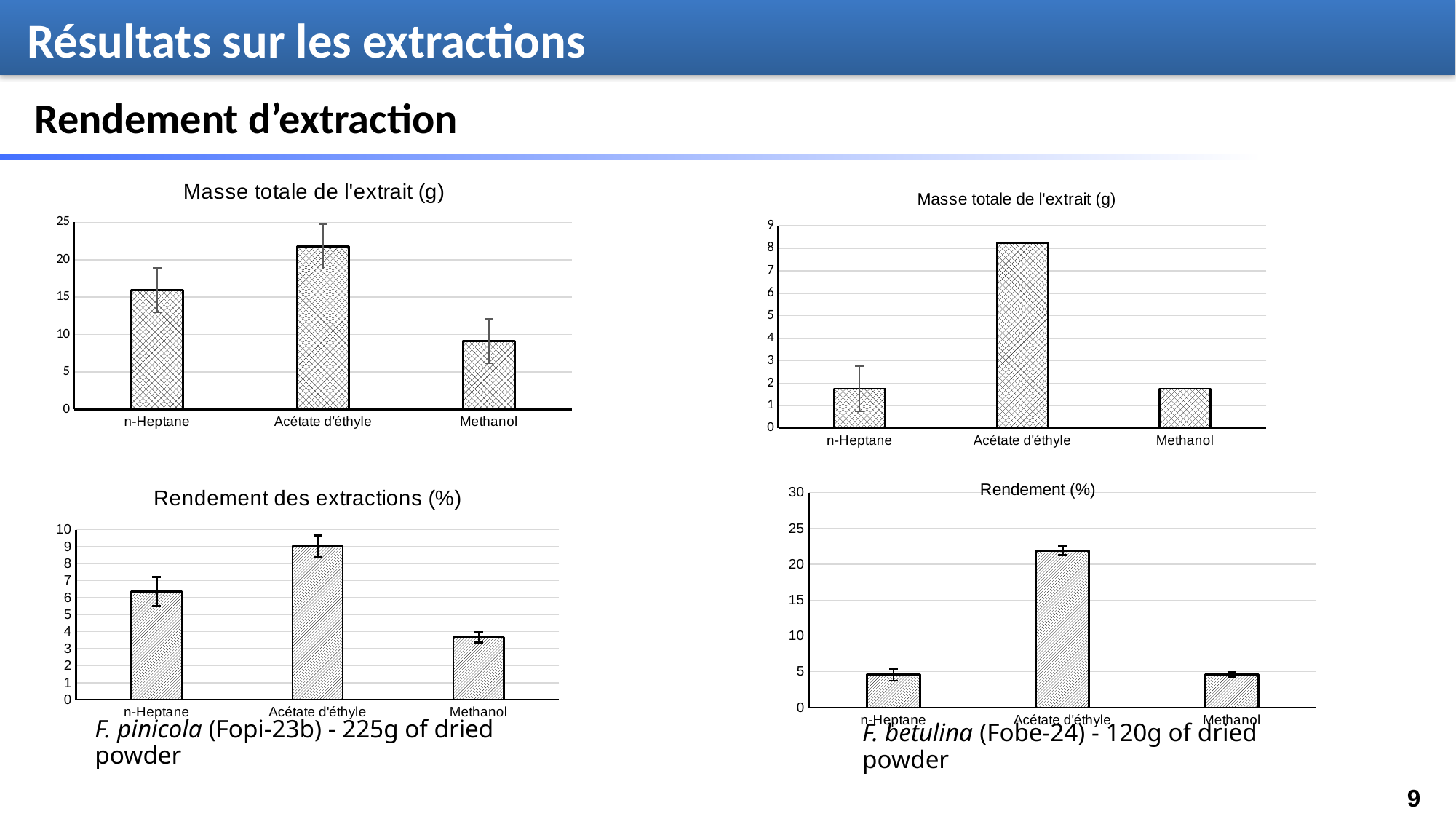
In the top-right chart (Masse totale de l'extrait, F. betulina), is the value for n-Heptane greater or less than 2? less In the bottom-right chart (Rendement %), which is larger, the yield for Acétate d'éthyle or for Methanol? Acétate d'éthyle In the top-left chart (Masse totale de l'extrait, F. pinicola), which solvent gives the highest total extract mass? Acétate d'éthyle In the top-right chart (Masse totale de l'extrait, F. betulina), is the value for Acétate d'éthyle greater or less than 8? greater In the bottom-right chart (Rendement %), is the yield for Acétate d'éthyle greater or less than 20? greater In the bottom-left chart (Rendement des extractions %), which solvent has the lowest yield? Methanol How many solvent categories are shown in the bottom-right chart (Rendement %)? 3 In the top-left chart (Masse totale de l'extrait, F. pinicola), which solvent gives the lowest total extract mass? Methanol In the top-right chart (Masse totale de l'extrait, F. betulina), which solvent gives the highest total extract mass? Acétate d'éthyle